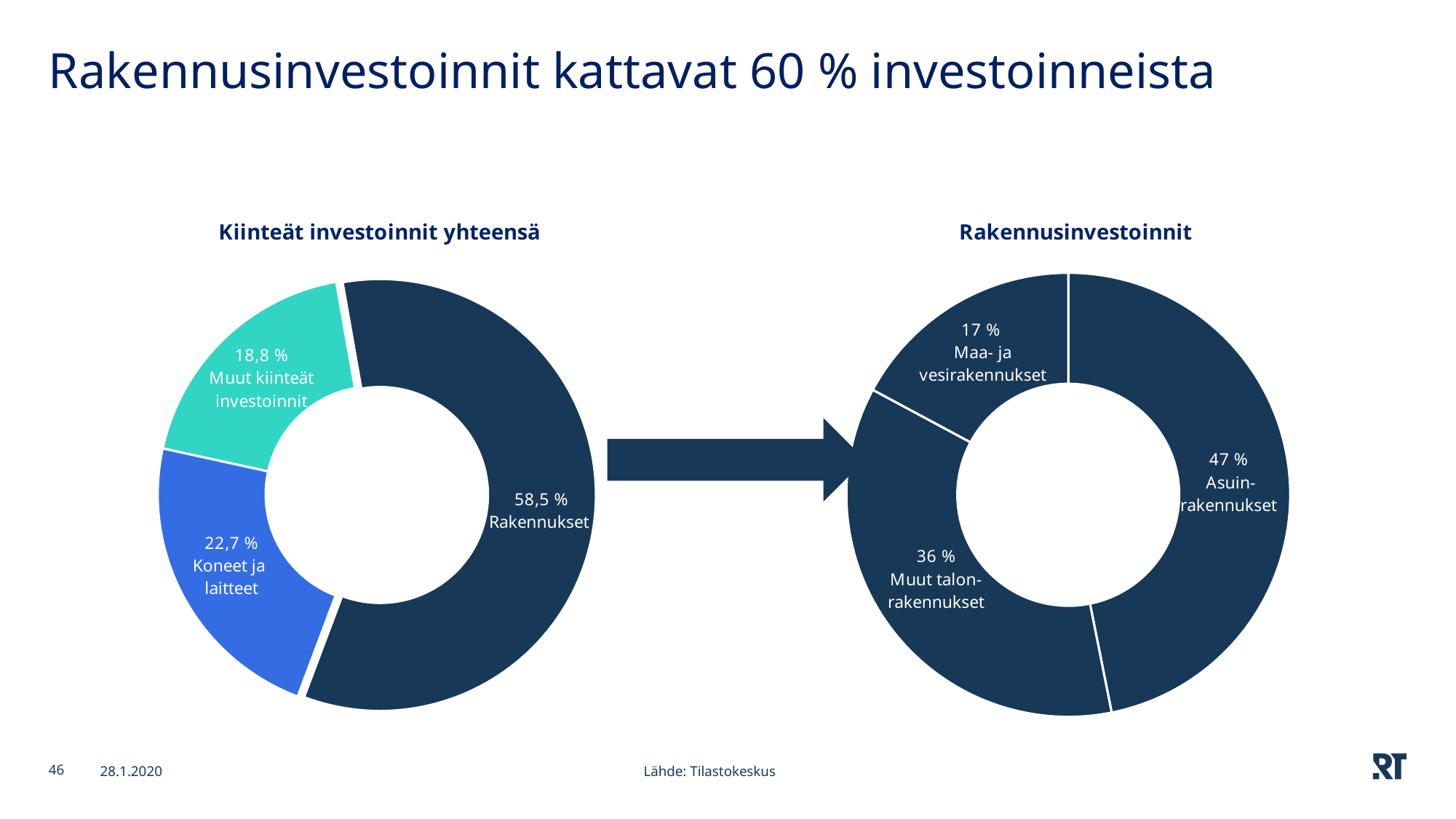
What kind of chart is the 'Kiinteät investoinnit yhteensä' chart? Doughnut (pie) chart In the 'Rakennusinvestoinnit' chart, what is the difference between the shares of Asuinrakennukset and Muut talonrakennukset? 11 % In the 'Kiinteät investoinnit yhteensä' chart, what share does Muut kiinteät investoinnit have? 18,8 % In the 'Rakennusinvestoinnit' chart, which category has the smallest share? Maa- ja vesirakennukset In the 'Kiinteät investoinnit yhteensä' chart, which category has the smallest share? Muut kiinteät investoinnit In the 'Kiinteät investoinnit yhteensä' chart, what is the difference between the shares of Koneet ja laitteet and Muut kiinteät investoinnit? 3,9 % In the 'Rakennusinvestoinnit' chart, what share does Maa- ja vesirakennukset have? 17 % In the 'Kiinteät investoinnit yhteensä' chart, what share does Rakennukset have? 58,5 % In the 'Kiinteät investoinnit yhteensä' chart, what share does Koneet ja laitteet have? 22,7 % In the 'Rakennusinvestoinnit' chart, which category has the largest share? Asuinrakennukset In the 'Rakennusinvestoinnit' chart, what share does Asuinrakennukset have? 47 % How many categories does the 'Rakennusinvestoinnit' chart show? 3